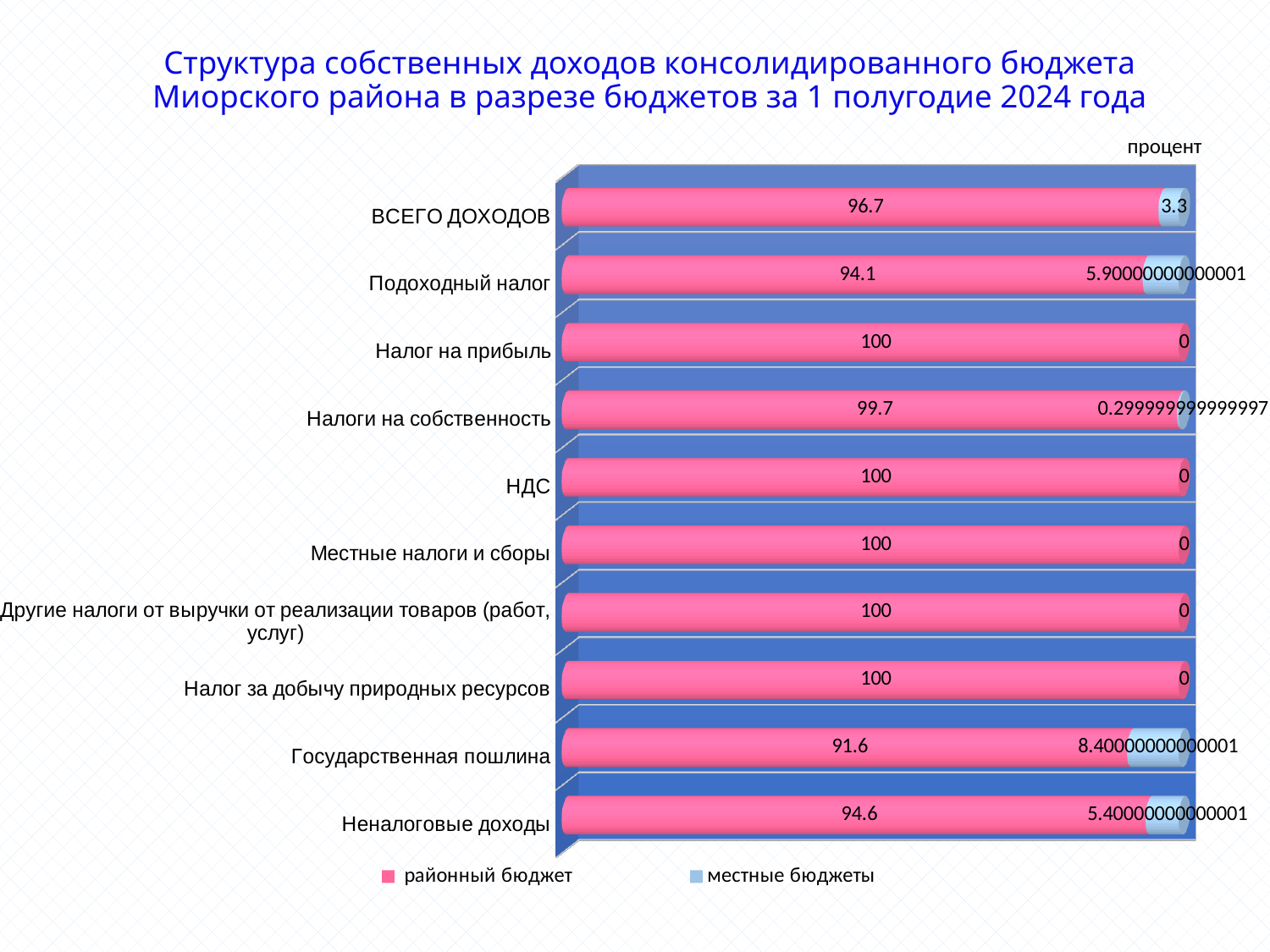
Which category has the lowest value for районный бюджет? Государственная пошлина What unit label is shown above the chart? процент How many series does the legend list? 2 What kind of chart is shown on the slide? Bar chart What is the value for районный бюджет for ВСЕГО ДОХОДОВ? 96.7 What is the value for местные бюджеты for ВСЕГО ДОХОДОВ? 3.3 Which is larger, the районный бюджет value for Неналоговые доходы or for Подоходный налог? Неналоговые доходы Which category has the highest value for местные бюджеты? Государственная пошлина How many categories are shown on the chart? 10 What is the difference between the районный бюджет values for ВСЕГО ДОХОДОВ and Подоходный налог? 2.6 What is the value for районный бюджет for Государственная пошлина? 91.6 What is the value for местные бюджеты for Подоходный налог, as printed on the slide? 5.90000000000001